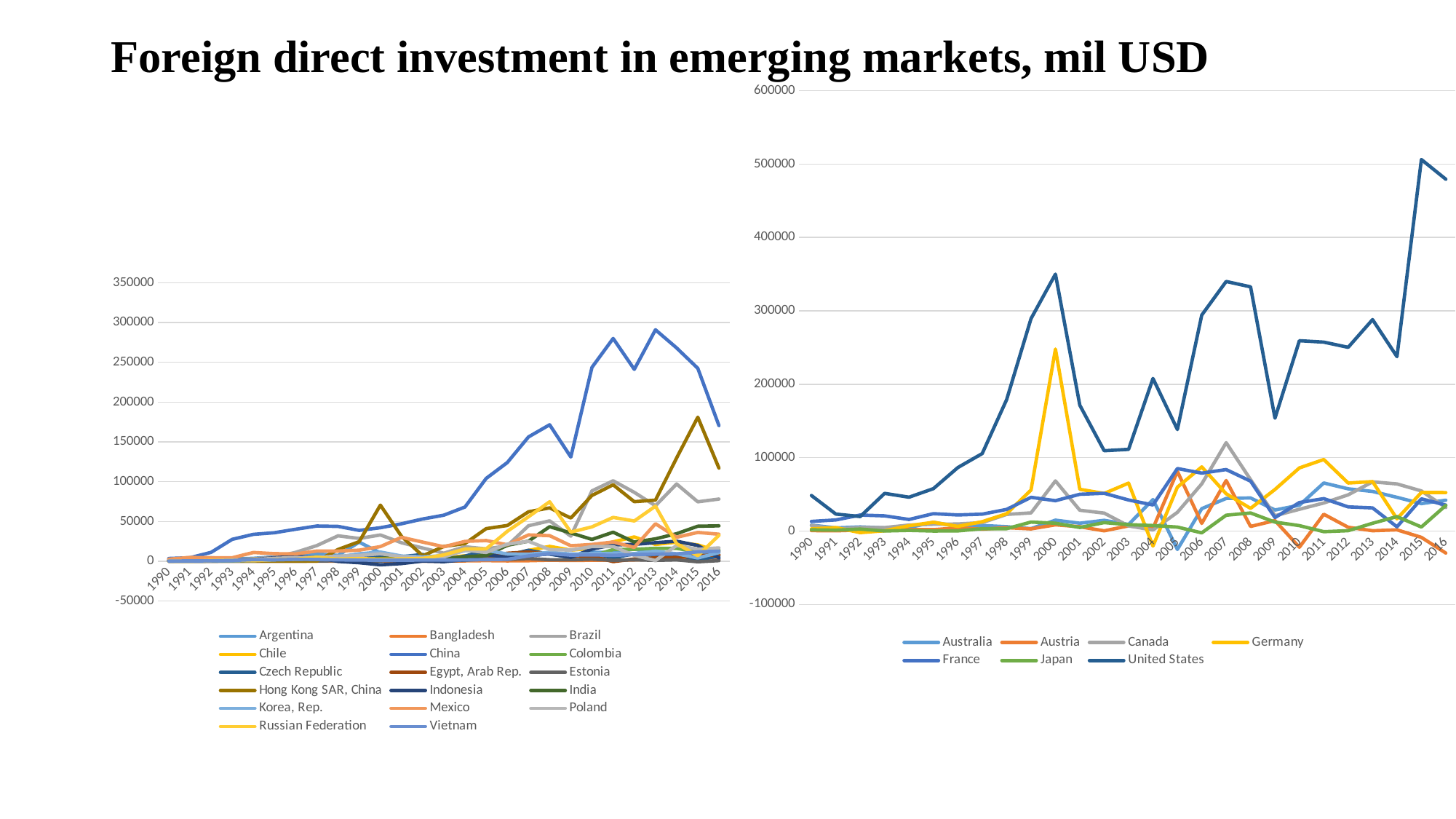
What is the title of the slide's chart? Foreign direct investment in emerging markets, mil USD In the right chart, is the value for Germany in 2000 greater or less than 200000? greater In the left chart, which series reaches the highest value? China How many series does the legend of the right chart list? 7 How many series does the legend of the left chart list? 17 In the right chart, which is larger in 2000: the United States or Germany? United States How many years are plotted along the x axis of the right chart? 27 In the left chart, is the value for China in 2013 greater or less than 250000? greater What kind of chart is the left chart on the slide? line chart In the right chart, which series reaches the highest value? United States In the left chart, which is larger in 2015: China or Hong Kong SAR, China? China In the right chart, is the value for the United States in 2009 greater or less than 200000? less